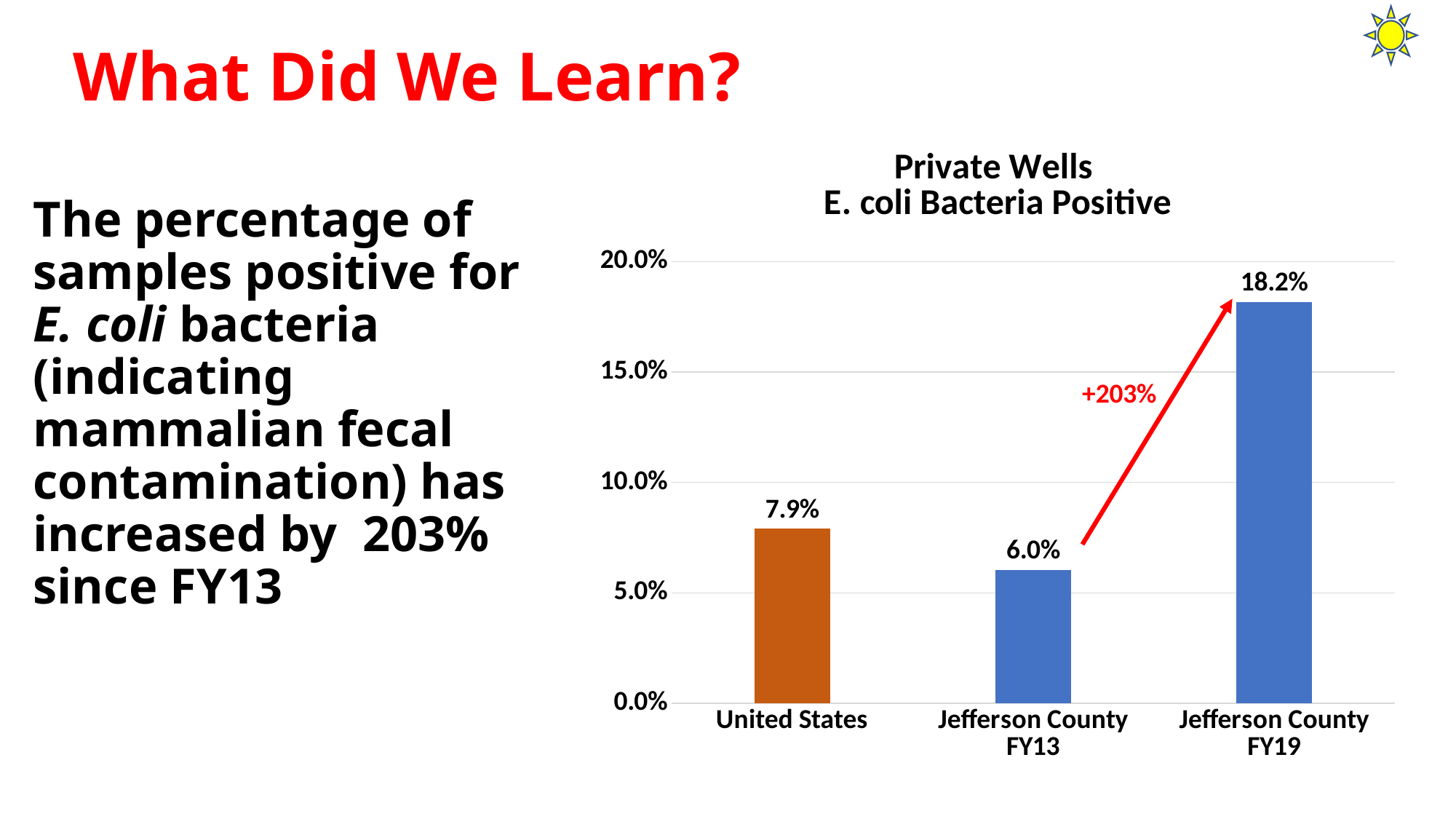
How many categories are shown on the chart? 3 What is the title of the chart? Private Wells E. coli Bacteria Positive What is the difference between the Jefferson County FY19 and Jefferson County FY13 values? 12.2% Which category has the highest value? Jefferson County FY19 Is the value for Jefferson County FY19 greater or less than 15.0%? greater Which is larger, the value for United States or the value for Jefferson County FY13? United States What is the difference between the United States and Jefferson County FY13 values? 1.9% What kind of chart is shown on the slide? Bar chart What is the value for United States? 7.9% What is the value for Jefferson County FY13? 6.0% Which category has the lowest value? Jefferson County FY13 What is the value for Jefferson County FY19? 18.2%